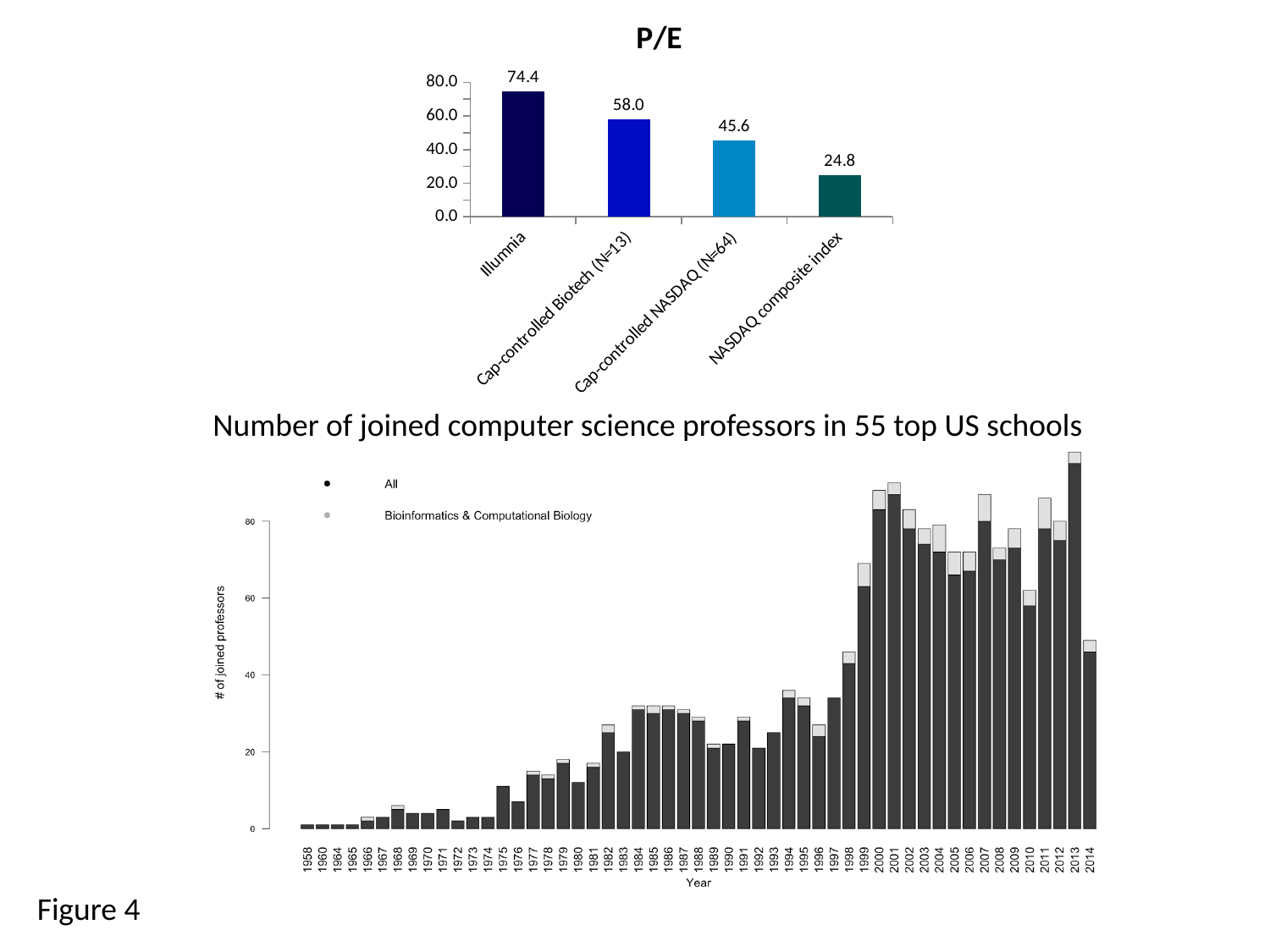
In the chart titled 'Number of joined computer science professors in 55 top US schools', how many series does the legend list? 2 In the chart titled 'Number of joined computer science professors in 55 top US schools', which year has the highest bar? 2013 In the P/E chart, what is the value for the NASDAQ composite index? 24.8 In the P/E chart, what is the value for Cap-controlled Biotech (N=13)? 58.0 In the P/E chart, what is the difference between the P/E of Illumnia and the NASDAQ composite index? 49.6 In the P/E chart, which category has the lowest P/E? NASDAQ composite index In the P/E chart, which is larger: Cap-controlled Biotech (N=13) or Cap-controlled NASDAQ (N=64)? Cap-controlled Biotech (N=13) In the P/E chart, how many categories are plotted? 4 In the P/E chart, what is the P/E value for Illumnia? 74.4 What kind of chart is the P/E chart? bar chart In the chart titled 'Number of joined computer science professors in 55 top US schools', is the value for 2013 greater or less than 80? greater In the P/E chart, which category has the highest P/E? Illumnia